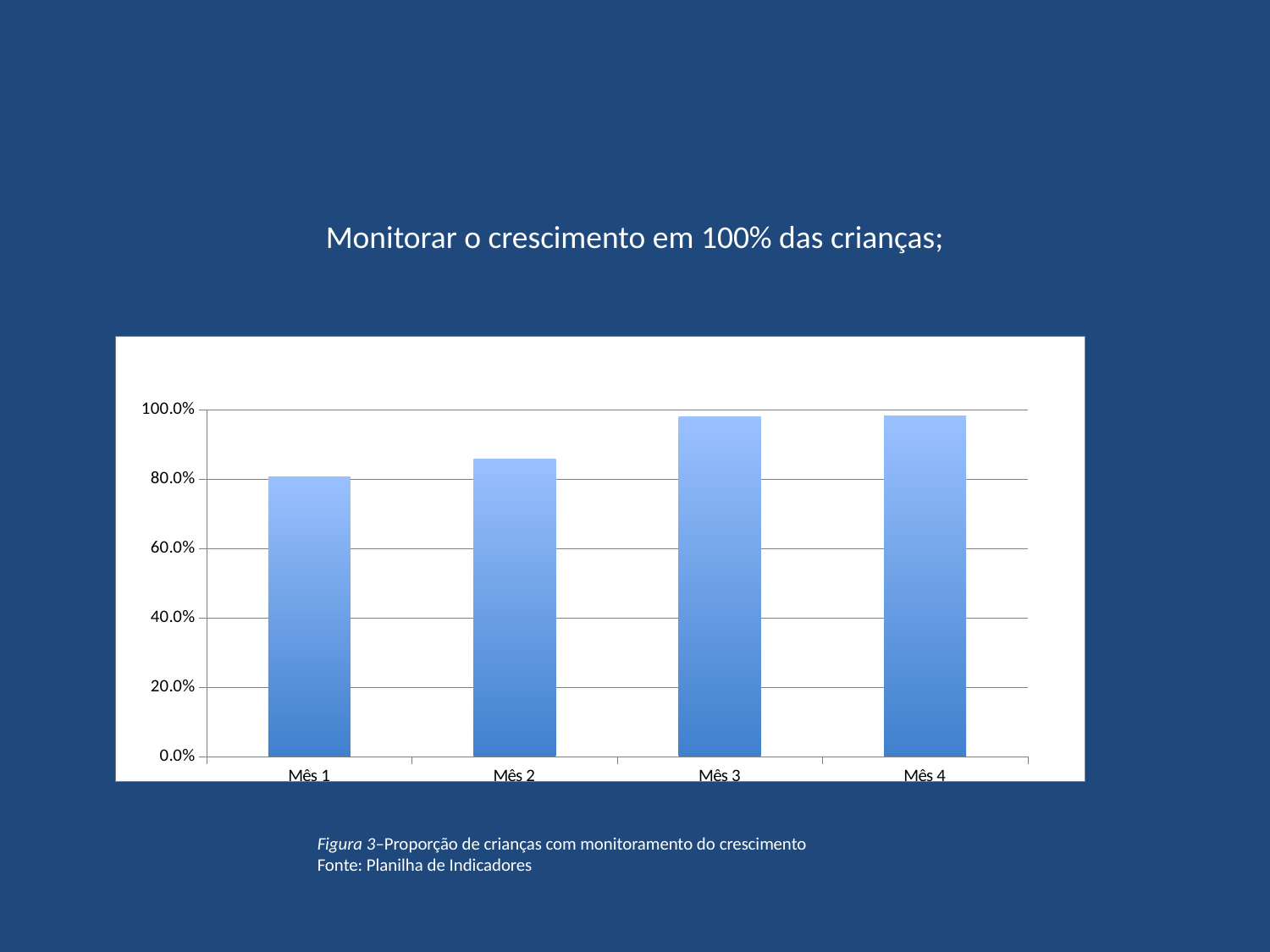
Do the values generally rise or fall from Mês 1 to Mês 4? rise Is the value for Mês 3 greater or less than 80.0%? greater Which month has the lowest proportion of children with growth monitoring? Mês 1 Which is larger, the value for Mês 2 or the value for Mês 3? Mês 3 What is the source cited below the chart? Planilha de Indicadores Is the value for Mês 2 greater or less than 80.0%? greater What is the figure caption given below the chart? Figura 3–Proporção de crianças com monitoramento do crescimento Is the value for Mês 4 greater or less than 100.0%? less Which is larger, the value for Mês 1 or the value for Mês 2? Mês 2 What kind of chart is shown on the slide? bar chart How many months (categories) are plotted on the x axis? 4